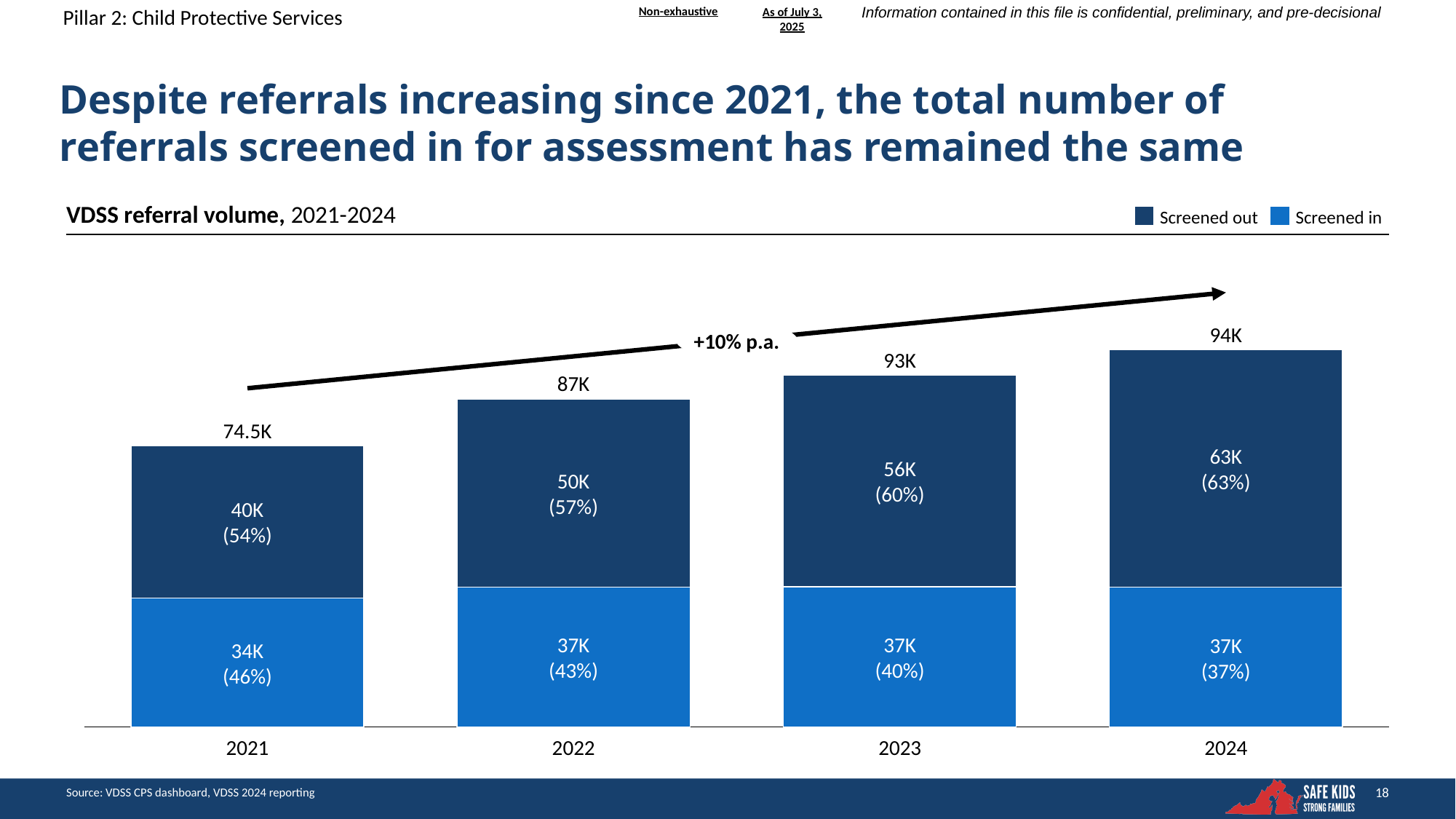
What is the difference between the Screened out values for 2024 and 2021? 23K What is the total VDSS referral volume shown for 2021? 74.5K What kind of chart is shown on the slide? Stacked bar chart Which year has the highest total referral volume? 2024 How many series does the legend list? 2 What is the Screened in value for 2022? 37K What percentage of referrals were screened in in 2024? 37% Which is larger, the Screened out value for 2022 or the Screened out value for 2023? 2023 Which year has the lowest Screened out value? 2021 What annual growth rate is annotated on the arrow above the bars? +10% p.a. How many years are shown on the x axis? 4 What is the Screened out value for 2023? 56K